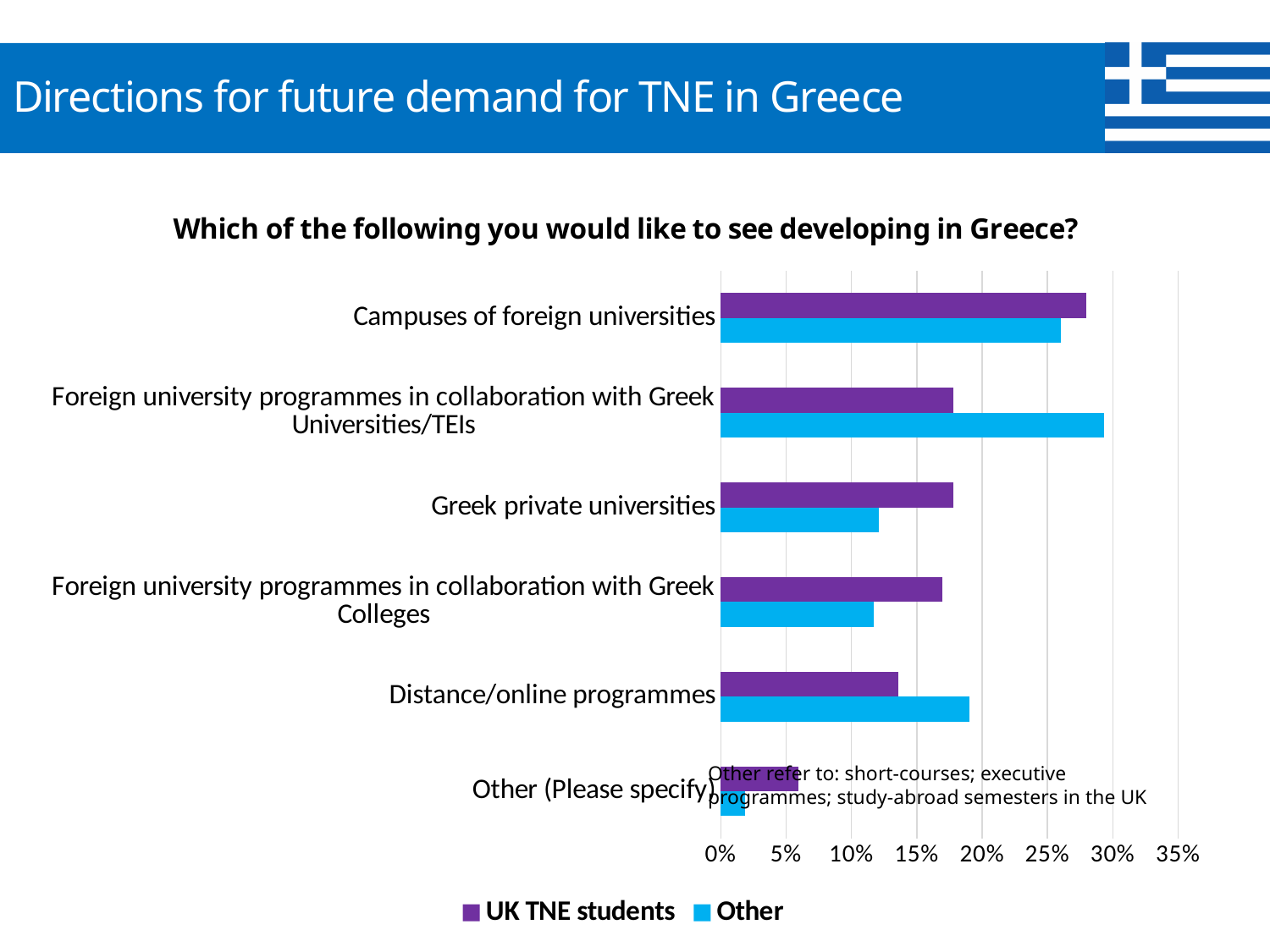
Is the Other value for Distance/online programmes greater or less than 20%? less How many categories are shown on the chart? 6 For Distance/online programmes, which series has the larger value: UK TNE students or Other? Other Which category has the lowest value for UK TNE students? Other (Please specify) Is the UK TNE students value for Campuses of foreign universities greater or less than 25%? greater Which category has the highest value for UK TNE students? Campuses of foreign universities Which category has the highest value for the Other series? Foreign university programmes in collaboration with Greek Universities/TEIs What is the title of the chart? Which of the following you would like to see developing in Greece? What kind of chart is shown on the slide? Bar chart Is the Other value for Greek private universities greater or less than 10%? greater For Greek private universities, which series has the larger value: UK TNE students or Other? UK TNE students How many series does the legend list? 2